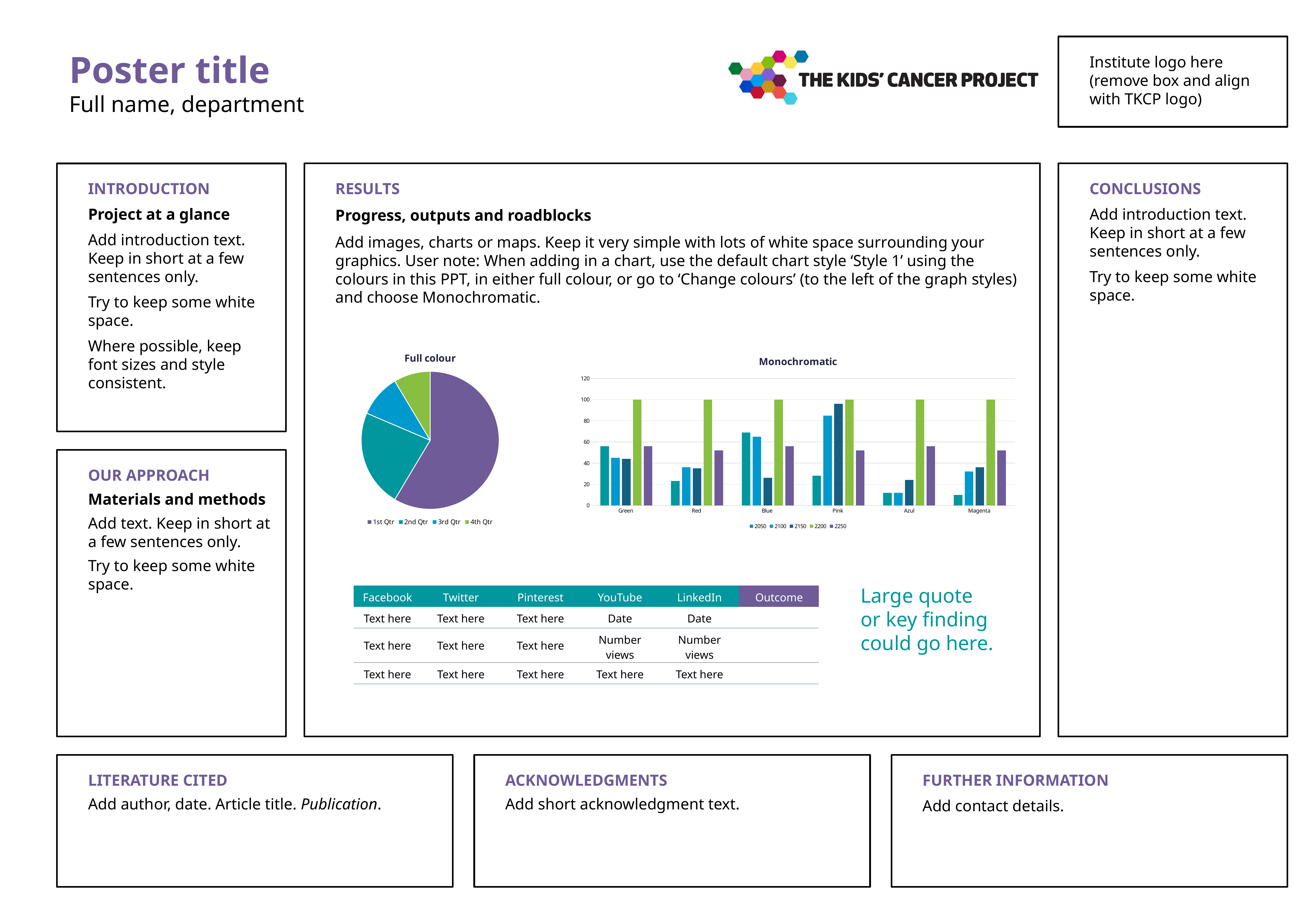
In the 'Monochromatic' chart, what is the value of the 2200 series for Green? 100 How many series does the legend of the 'Monochromatic' chart list? 5 In the 'Monochromatic' chart, which category has the highest 2050 value? Blue In the 'Monochromatic' chart, which is larger for the 2050 series: Green or Red? Green What kind of chart is the 'Monochromatic' chart? bar chart How many slices does the 'Full colour' pie chart have? 4 In the 'Full colour' pie chart, which quarter has the largest slice? 1st Qtr In the 'Monochromatic' chart, is the 2100 value for Pink greater or less than 80? greater How many categories are shown on the x axis of the 'Monochromatic' chart? 6 What kind of chart is the 'Full colour' chart? pie chart In the 'Full colour' pie chart, which quarter has the smallest slice? 4th Qtr In the 'Monochromatic' chart, is the 2050 value for Red greater or less than 40? less